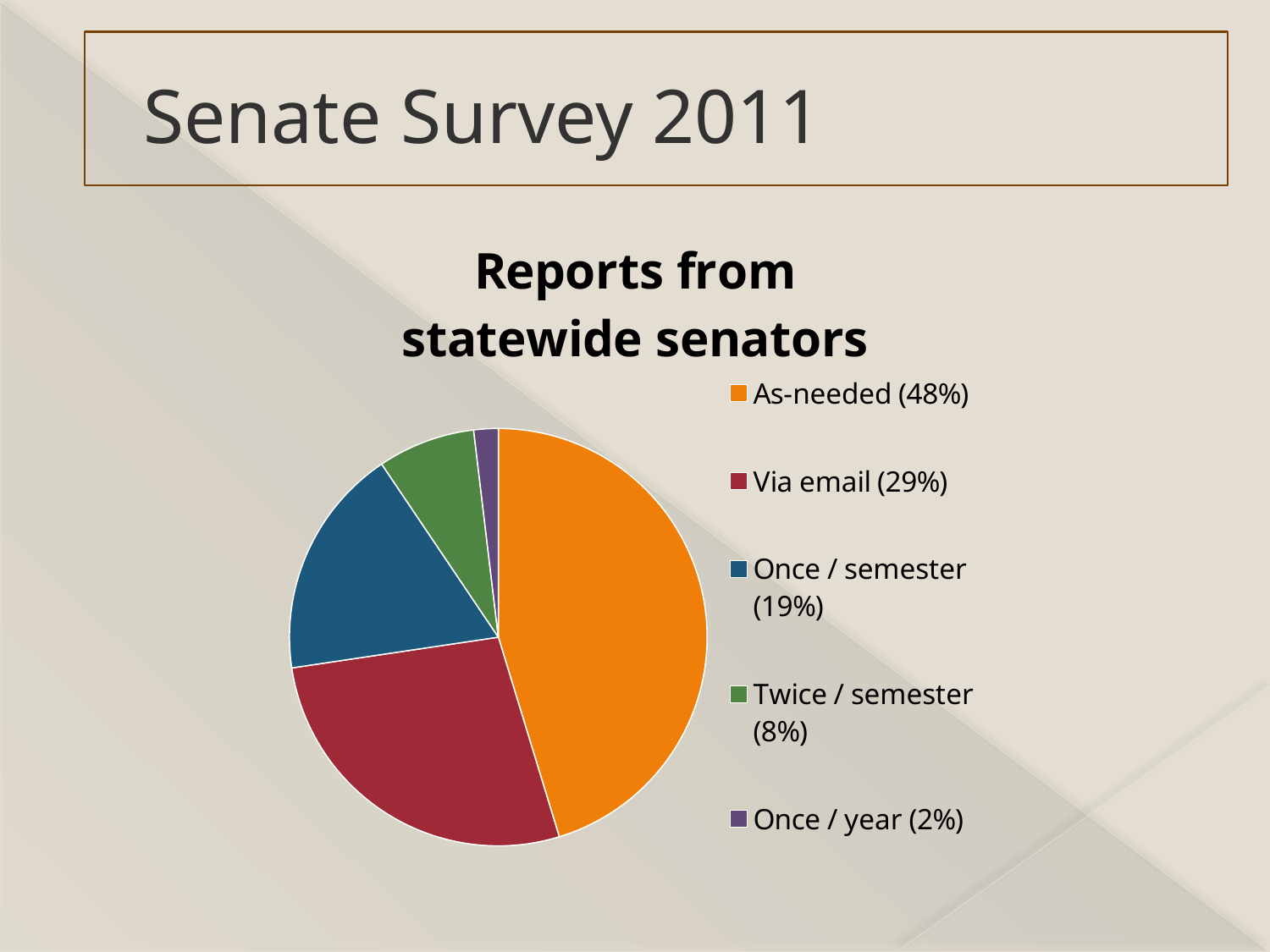
Which is larger, Once / semester or Twice / semester? Once / semester What is the title of the chart? Reports from statewide senators What share of the pie is Once / year? 2% Which category has the largest share of the pie? As-needed Which category has the smallest share of the pie? Once / year What share of the pie is Twice / semester? 8% What share of the pie is As-needed? 48% What is the difference in percentage points between As-needed and Via email? 19 What kind of chart is shown on the slide? Pie chart How many categories does the pie chart have? 5